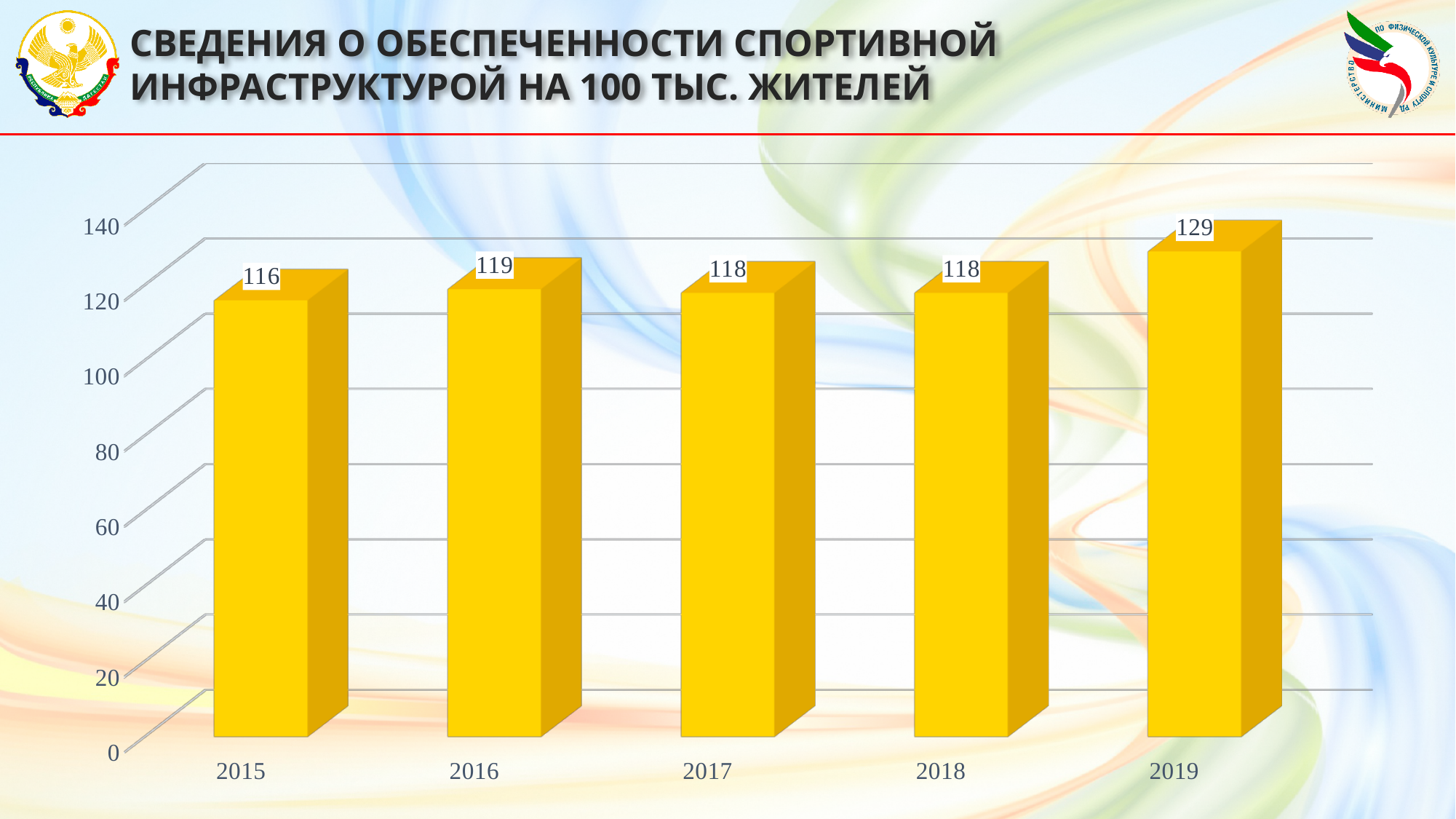
What kind of chart is shown on the slide? bar chart What is the difference between the values for 2019 and 2015? 13 How many years are shown on the chart? 5 Which year has the lowest value? 2015 What colour are the bars on the chart? yellow Which year has the highest value? 2019 What is the value for 2015? 116 What is the value for 2016? 119 Which is larger, the value for 2018 or the value for 2019? 2019 What is the difference between the values for 2016 and 2017? 1 Is the value for 2017 greater or less than 100? greater What is the value for 2019? 129